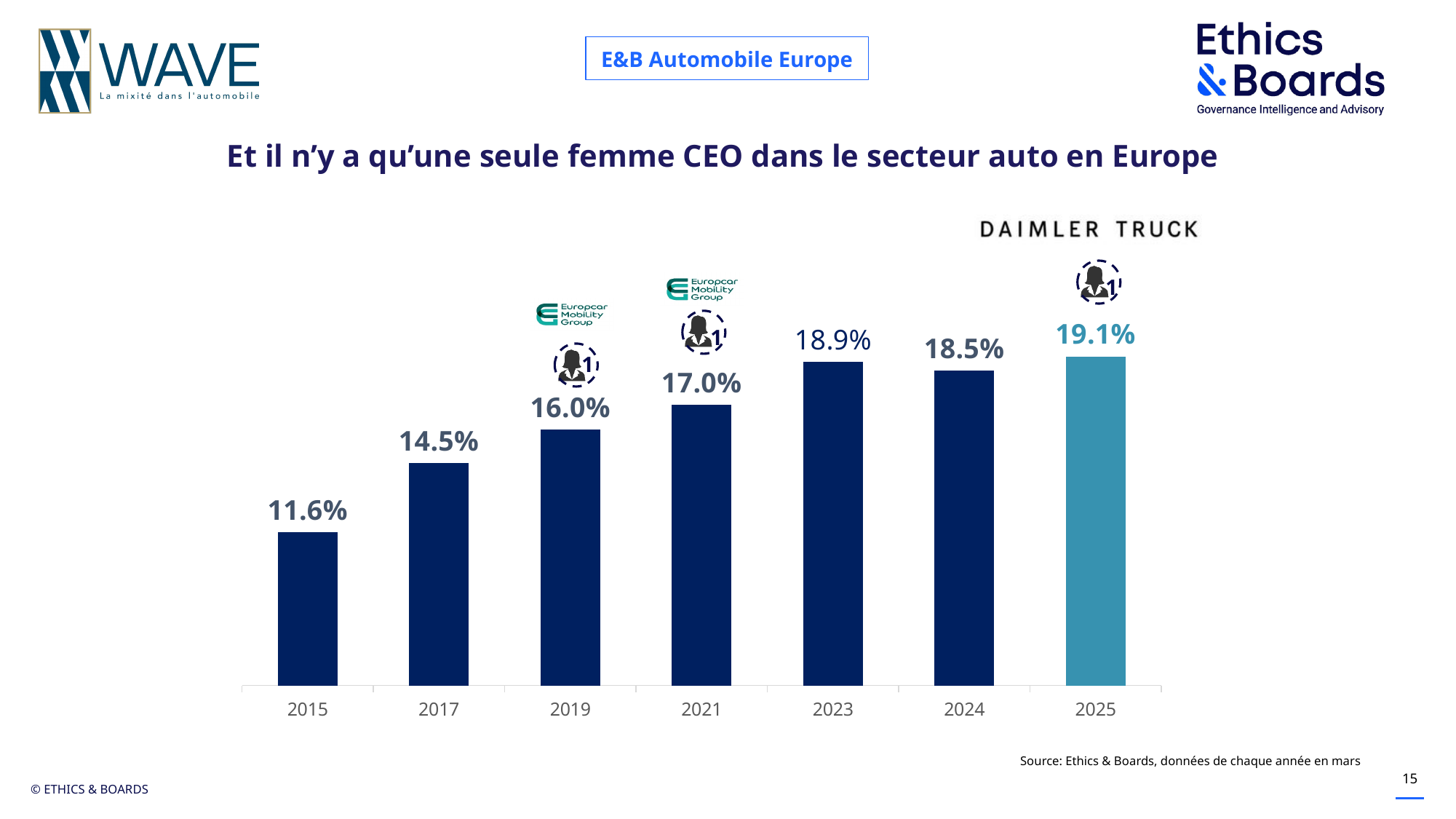
How many years are shown on the x axis? 7 What is the value shown for 2021? 17.0% Which company name appears above the 2025 bar? Daimler Truck Which is larger, the value for 2019 or the value for 2017? 2019 Which year has the highest value? 2025 What is the value shown for 2015? 11.6% Do the values generally rise or fall from 2015 to 2025? Rise What kind of chart is shown on the slide? Bar chart What is the difference between the values for 2025 and 2015? 7.5 percentage points What is the difference between the values for 2023 and 2024? 0.4 percentage points Which year has the lowest value? 2015 What is the value shown for 2025? 19.1%